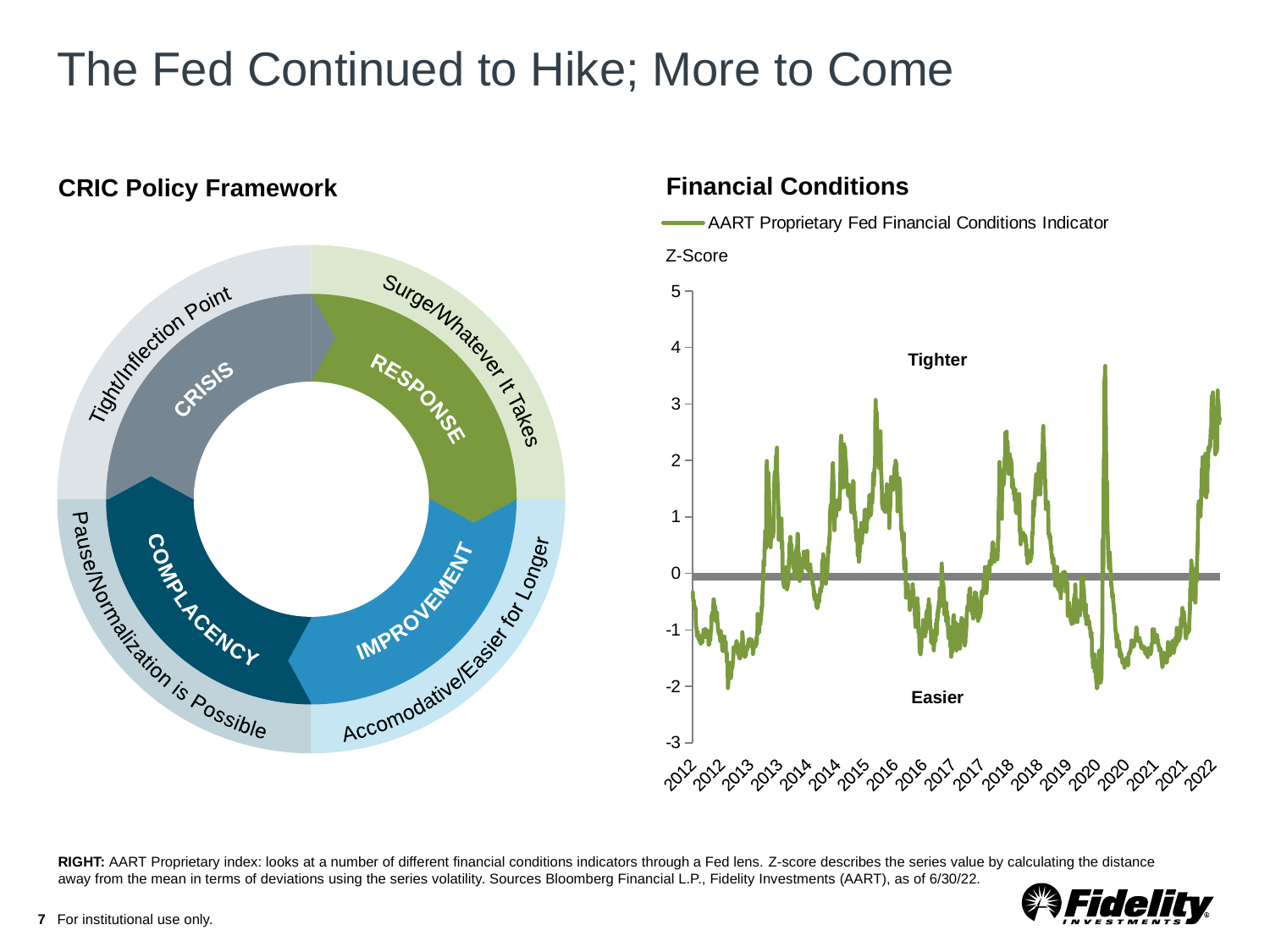
In the Financial Conditions chart, in which year does the indicator reach its highest peak? 2020 In the Financial Conditions chart, is the 2020 peak of the indicator higher or lower than the 2015 peak? higher In the Financial Conditions chart, is the value of the indicator in mid-2016 greater or less than 0? less What unit or measure is labelled on the y axis of the Financial Conditions chart? Z-Score How many series does the legend of the Financial Conditions chart list? 1 In the Financial Conditions chart, is the lowest value of the indicator in early 2013 greater or less than -1? less What kind of chart is the Financial Conditions chart? line chart In the Financial Conditions chart, is the peak value of the indicator in 2015 greater or less than 2? greater In the Financial Conditions chart, does the indicator rise or fall from 2021 to 2022? rise What is the name of the series shown in the Financial Conditions chart? AART Proprietary Fed Financial Conditions Indicator